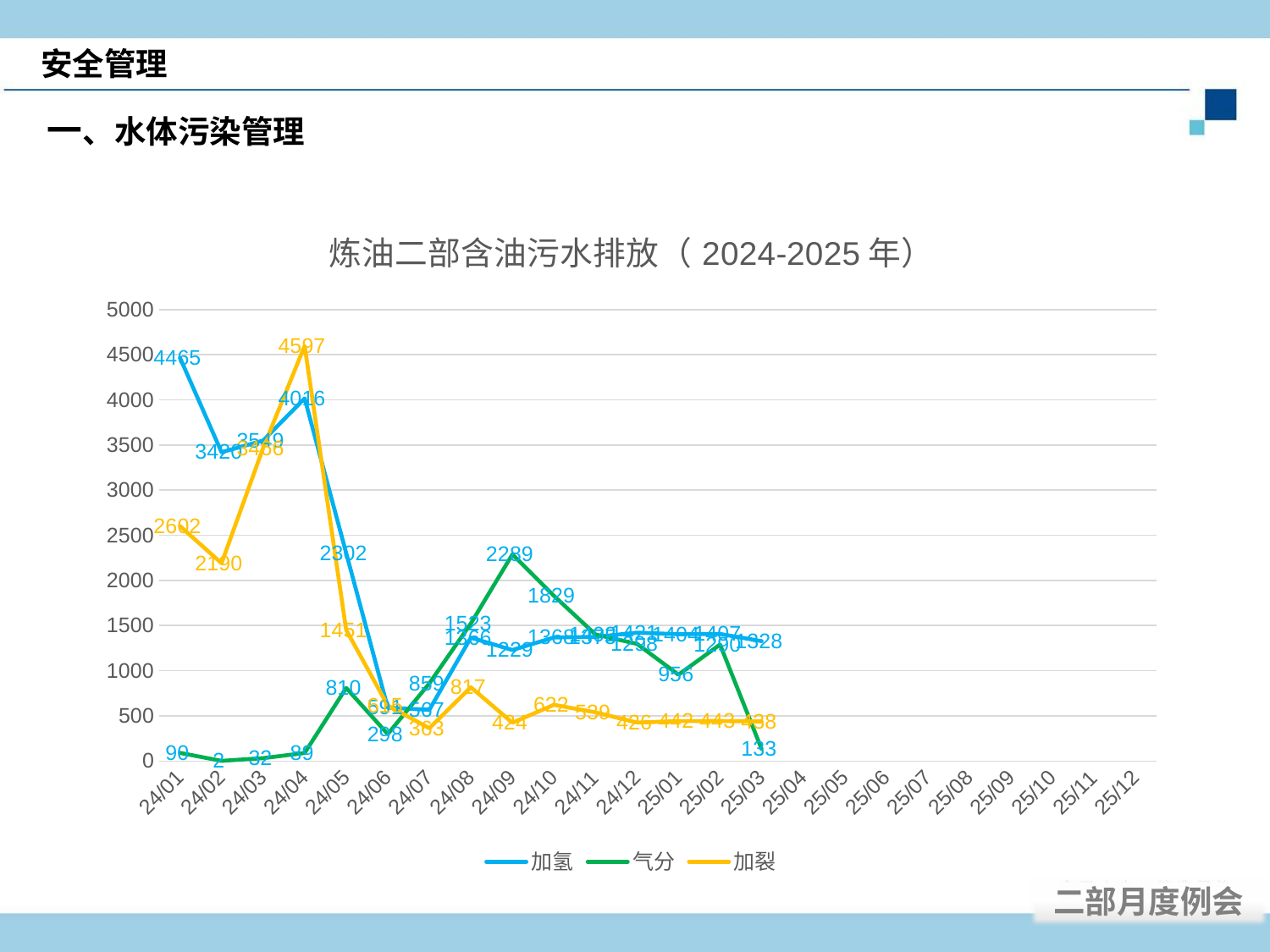
What is the value for 加裂 in 24/04? 4597 In which month does 气分 reach its lowest value? 24/02 Does the 加裂 line rise or fall from 24/04 to 24/05? fall What is the title of the chart? 炼油二部含油污水排放（2024-2025年） What is the difference between the 加氢 values in 24/01 and 24/04? 449 In which month does 加裂 reach its highest value? 24/04 What is the value for 气分 in 25/03? 133 What is the value for 气分 in 24/09? 2289 What kind of chart is shown on the slide? line chart How many series does the legend list? 3 In 24/05, which is larger, 加氢 or 加裂? 加氢 What is the value for 加氢 in 24/01? 4465